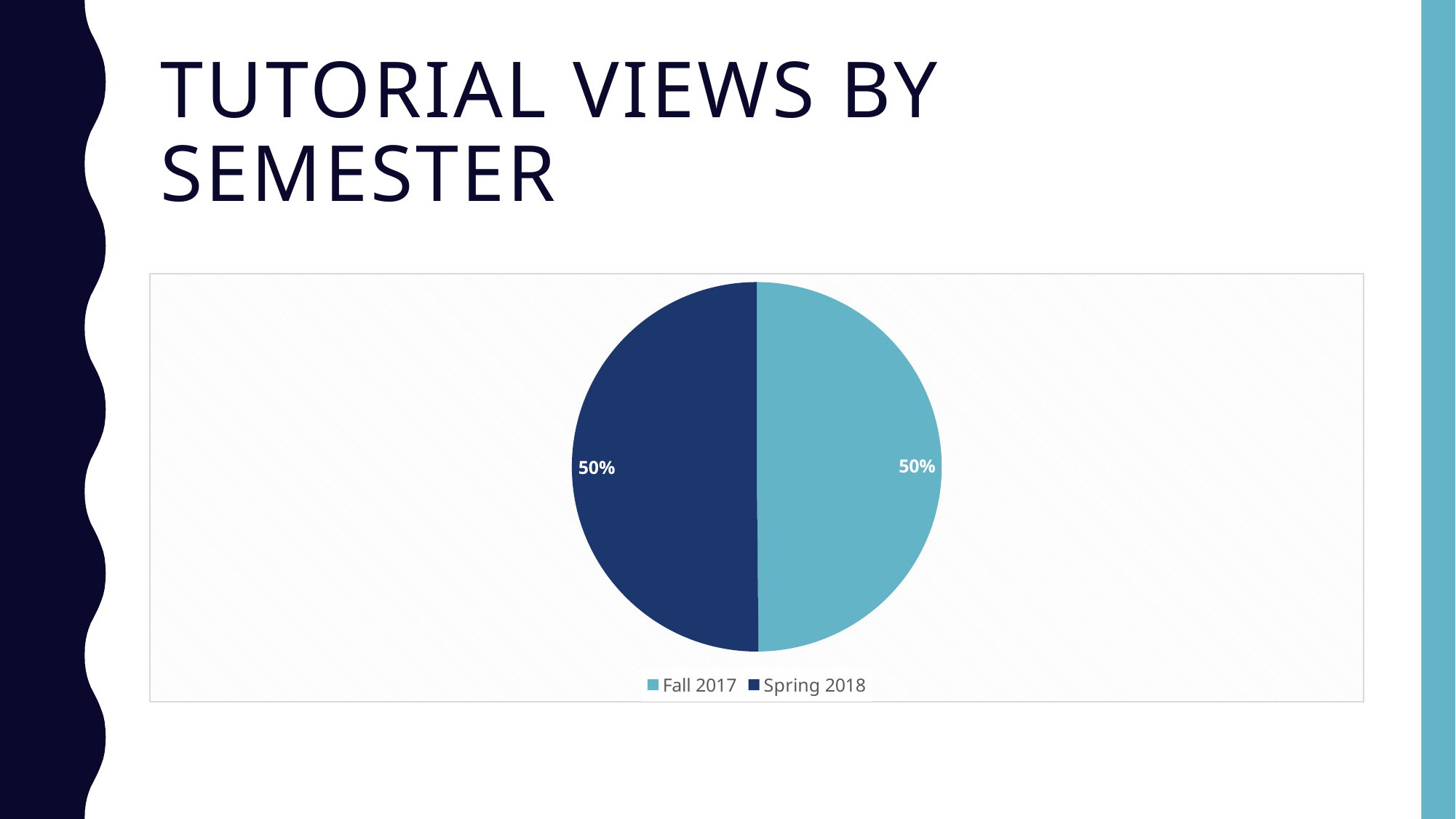
What is the title of the slide containing the chart? Tutorial Views by Semester What kind of chart is shown on the slide? pie chart What share of tutorial views does Fall 2017 have? 50% How many entries does the legend list? 2 Is the share for Spring 2018 larger than, smaller than, or equal to the share for Fall 2017? equal What is the combined share of the Fall 2017 and Spring 2018 slices? 100% What share of tutorial views does Spring 2018 have? 50% Which legend entry is shown in the darker blue colour? Spring 2018 How many slices does the pie chart have? 2 What is the difference between the Fall 2017 and Spring 2018 shares? 0%